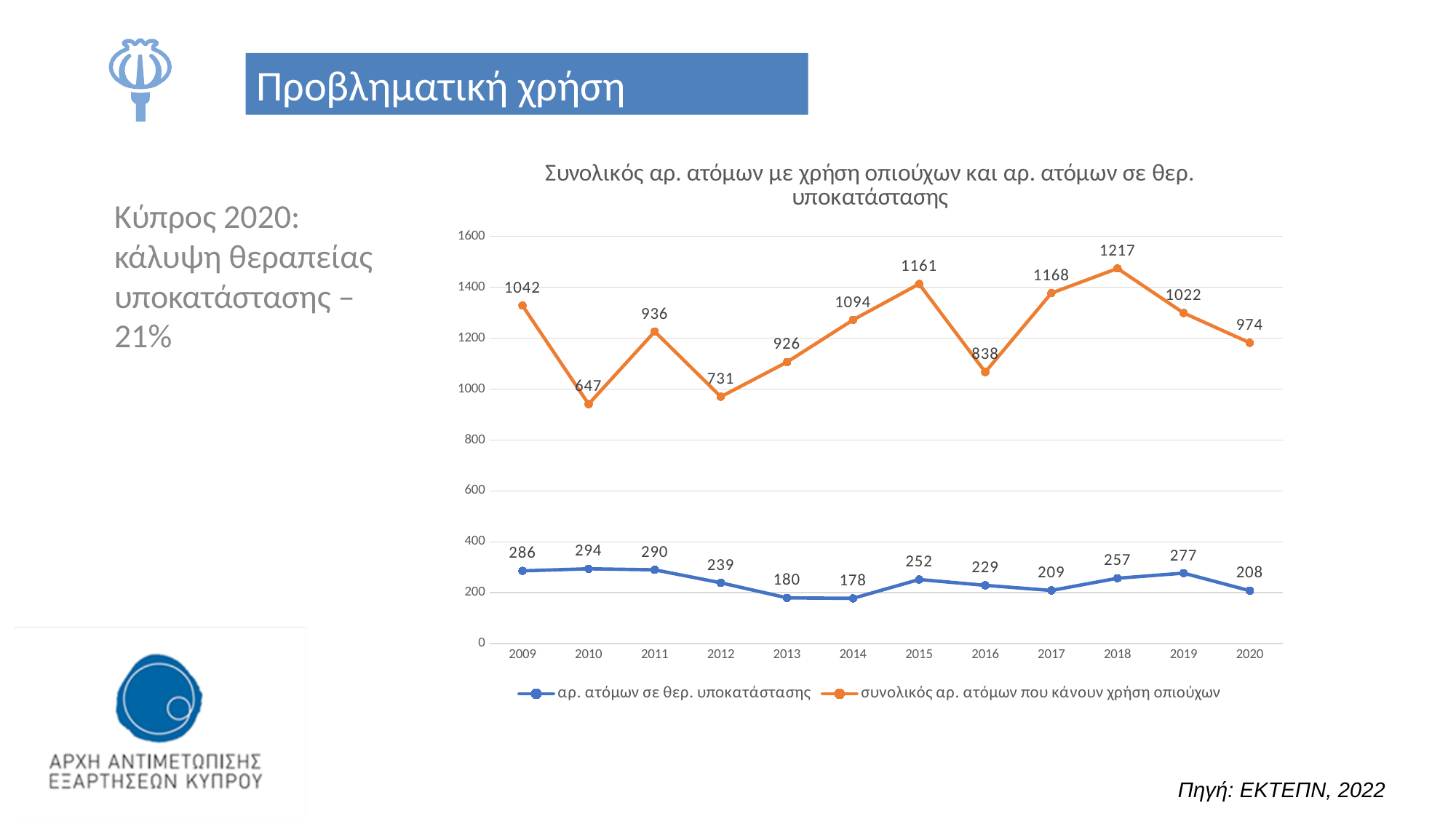
In which year is the labelled value for 'συνολικός αρ. ατόμων που κάνουν χρήση οπιούχων' highest? 2018 In which year is the labelled value for 'αρ. ατόμων σε θερ. υποκατάστασης' lowest? 2014 What type of chart is shown on the slide? Line chart By how much did the labelled value for 'συνολικός αρ. ατόμων που κάνουν χρήση οπιούχων' fall from 2018 to 2019? 195 What is the difference between the two series' labelled values in 2020? 766 Which colour is used for the 'αρ. ατόμων σε θερ. υποκατάστασης' series? Blue How many years are shown on the x axis? 12 Which is larger: the 'αρ. ατόμων σε θερ. υποκατάστασης' value in 2010 or in 2020? 2010 What is the value for 'συνολικός αρ. ατόμων που κάνουν χρήση οπιούχων' in 2020? 974 What is the value for 'αρ. ατόμων σε θερ. υποκατάστασης' in 2013? 180 In which year is the labelled value for 'συνολικός αρ. ατόμων που κάνουν χρήση οπιούχων' lowest? 2010 How many series does the legend list? 2